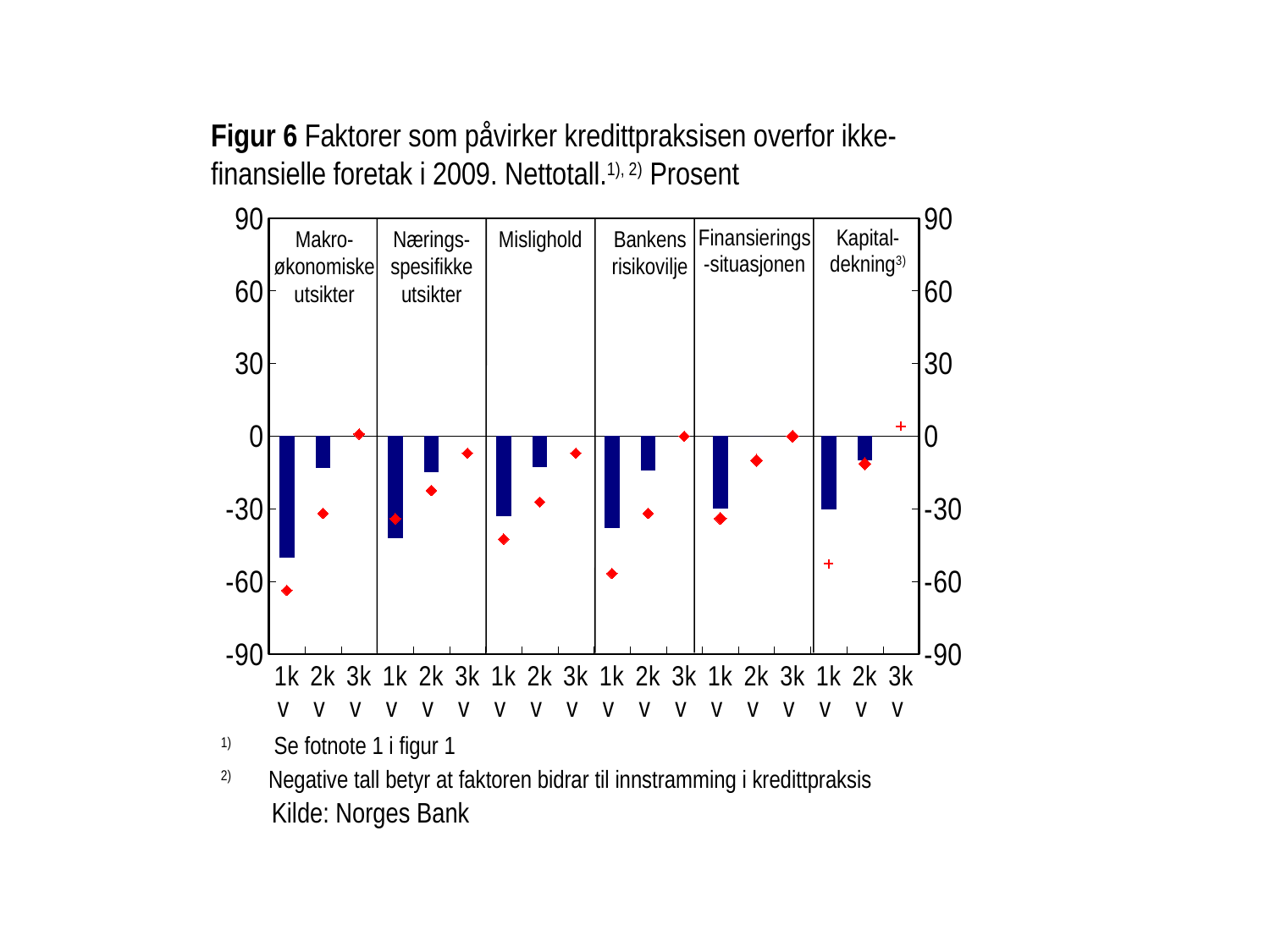
Is the red diamond marker for 1k under Makroøkonomiske utsikter greater or less than -30? less According to footnote 2, what do negative numbers in the chart mean? The factor contributes to tightening of credit practice (innstramming i kredittpraksis) Within the Makroøkonomiske utsikter panel, do the bars rise or fall from 1k to 3k? rise What is the source cited for the chart? Norges Bank How many quarters (1k, 2k, 3k) are shown within each factor panel? 3 Which bar is more negative: 1k or 2k under Næringsspesifikke utsikter? 1k How many factor panels are shown in the chart? 6 Is the 1k bar for Makroøkonomiske utsikter greater or less than -30? less Which factor has the lowest (most negative) bar in the chart? Makroøkonomiske utsikter (1k) Is the 2k bar for Mislighold greater or less than -30? greater What kind of chart is shown on the slide? combination bar and line chart (bars with red diamond markers)